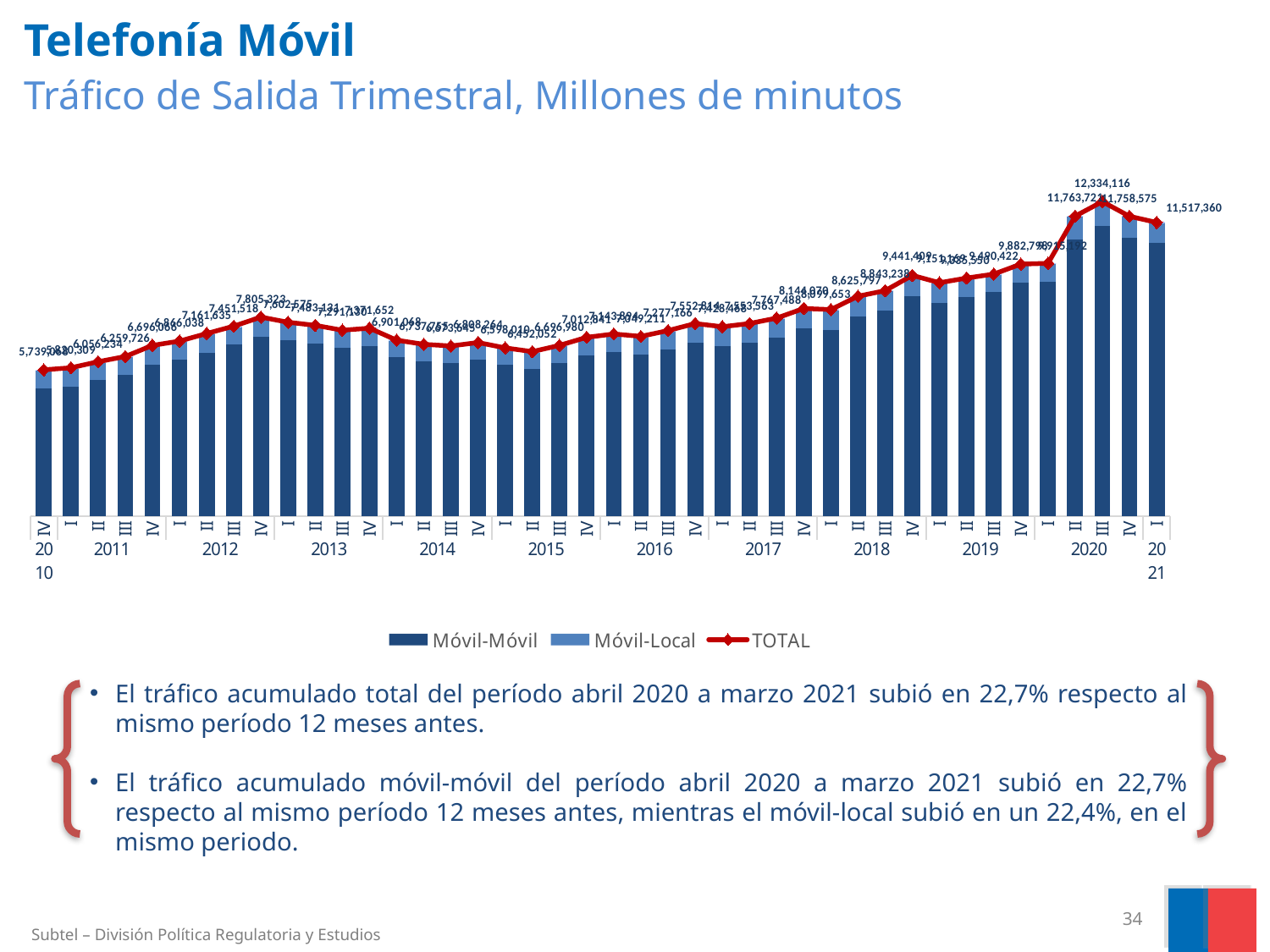
What is the TOTAL value for the first quarter (I) of 2021? 11,517,360 Which series is shown as the red line in the chart? TOTAL What is the TOTAL value for the third quarter (III) of 2020? 12,334,116 What kind of chart is shown on the slide? Stacked bar chart with a line In which quarter does the TOTAL line reach its highest value? III 2020 What is the TOTAL value for the fourth quarter (IV) of 2010? 5,739,068 Which is larger, the TOTAL for III 2020 or the TOTAL for I 2021? III 2020 Does the TOTAL line generally rise or fall from IV 2010 to III 2020? Rise How many series does the legend list? 3 In which quarter is the TOTAL line at its lowest value? IV 2010 What is the difference between the TOTAL for III 2020 and the TOTAL for IV 2020? 575,541 What is the TOTAL value for the fourth quarter (IV) of 2020? 11,758,575